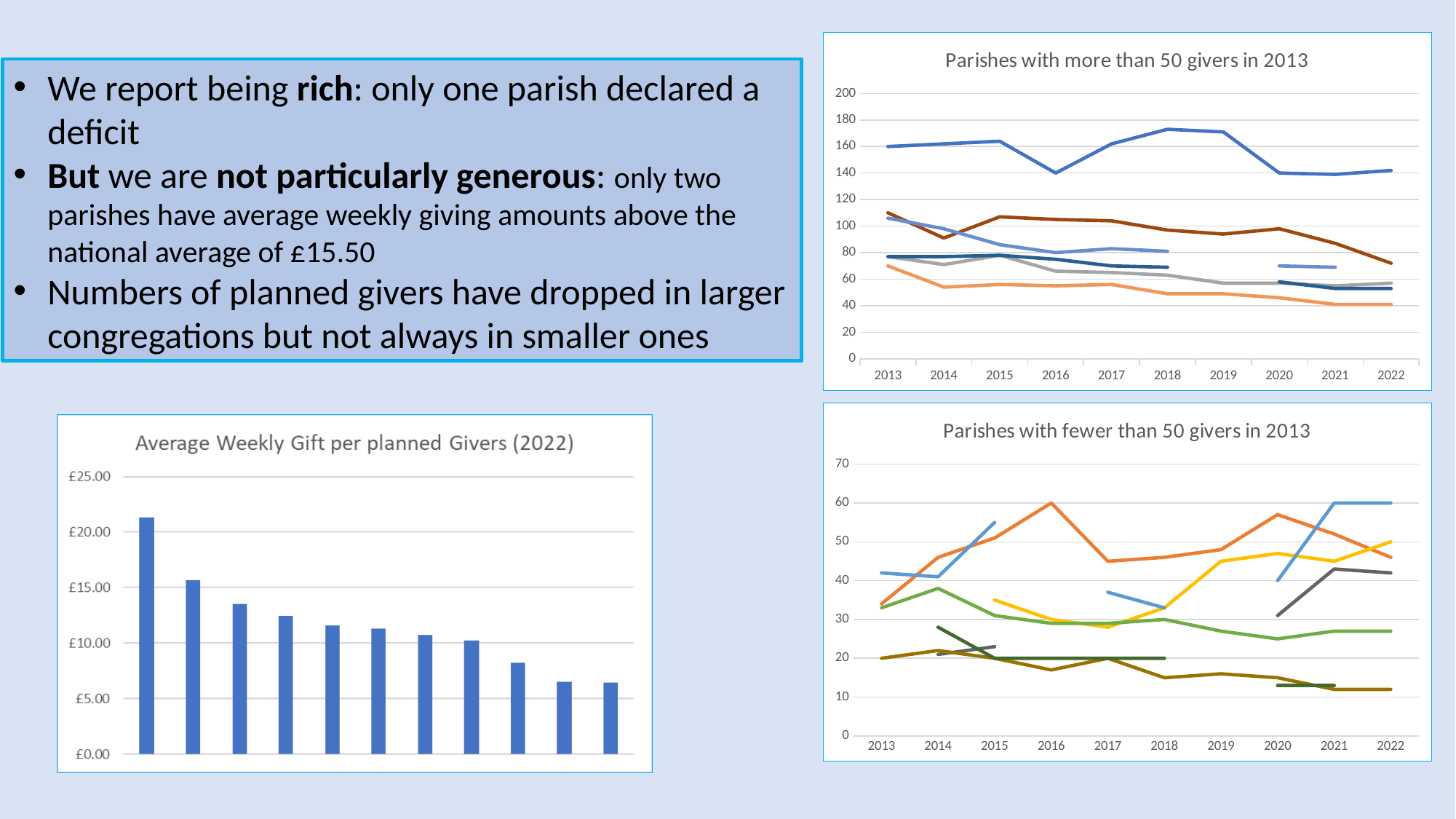
What kind of chart is 'Average Weekly Gift per planned Givers (2022)'? bar chart How many bars are plotted in the 'Average Weekly Gift per planned Givers (2022)' chart? 11 In the 'Average Weekly Gift per planned Givers (2022)' chart, is the value of the rightmost bar greater or less than £10.00? less In the 'Parishes with more than 50 givers in 2013' chart, is the value of the highest line in 2013 greater or less than 140? greater In the 'Average Weekly Gift per planned Givers (2022)' chart, do the bar values rise or fall from left to right? fall How many years are shown on the x axis of the 'Parishes with more than 50 givers in 2013' chart? 10 What is the highest value shown on the y axis of the 'Parishes with fewer than 50 givers in 2013' chart? 70 What kind of chart is 'Parishes with fewer than 50 givers in 2013'? line chart What is the highest value shown on the y axis of the 'Parishes with more than 50 givers in 2013' chart? 200 In the 'Parishes with fewer than 50 givers in 2013' chart, is the value of the orange line in 2016 greater or less than 50? greater What kind of chart is 'Parishes with more than 50 givers in 2013'? line chart